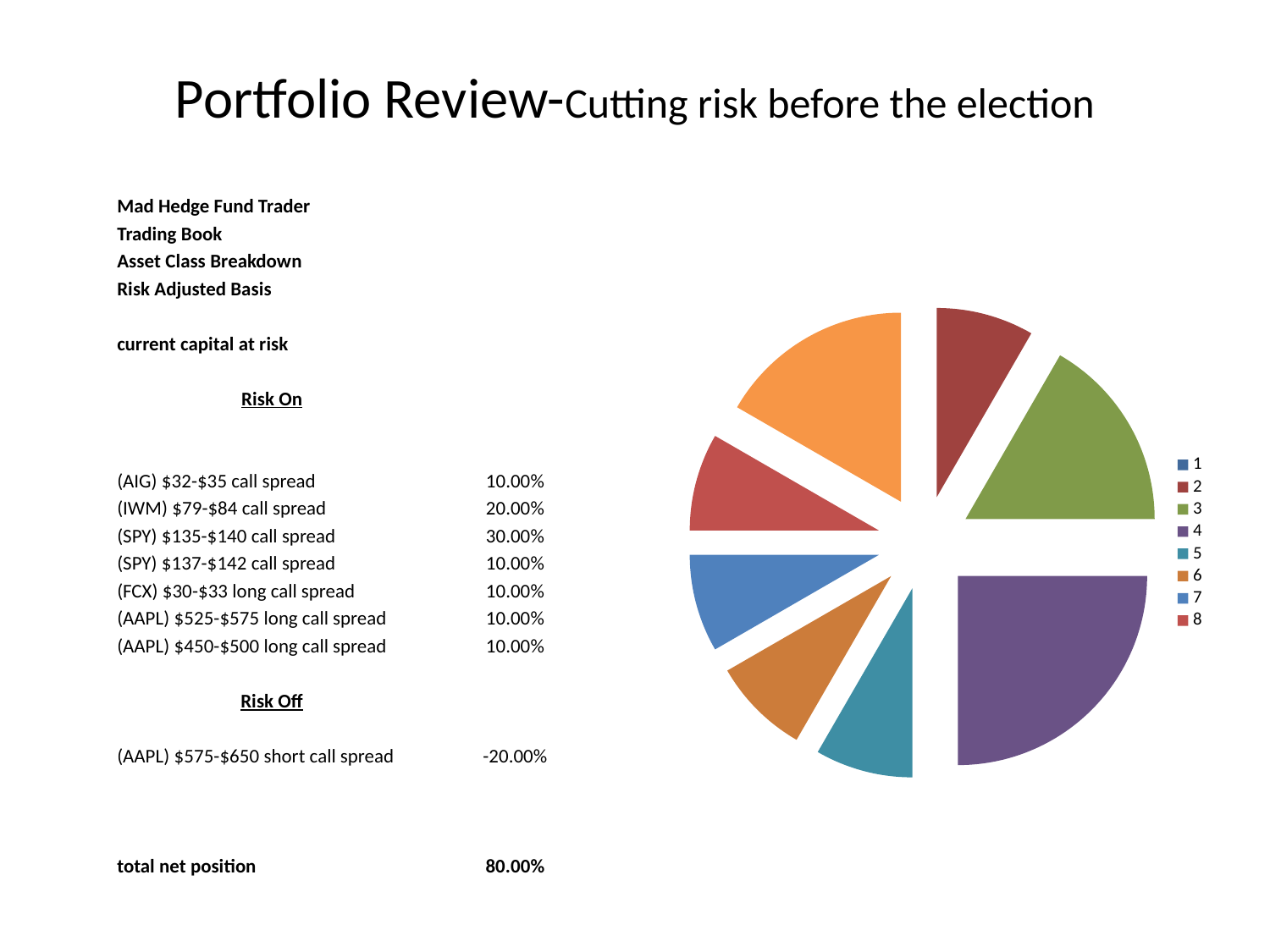
What kind of chart is shown on the slide? pie chart Which is larger in the pie chart, the purple slice or the green slice? purple Which is larger in the pie chart, the green slice or the teal slice? green How many entries does the chart's legend list? 8 Which colour slice is the largest in the pie chart? purple How many slices does the pie chart have? 8 What colour is legend entry 4 in the pie chart? purple Which is larger in the pie chart, the purple slice or the dark red slice at the top? purple What labels are used for the entries in the chart's legend? the numbers 1 to 8